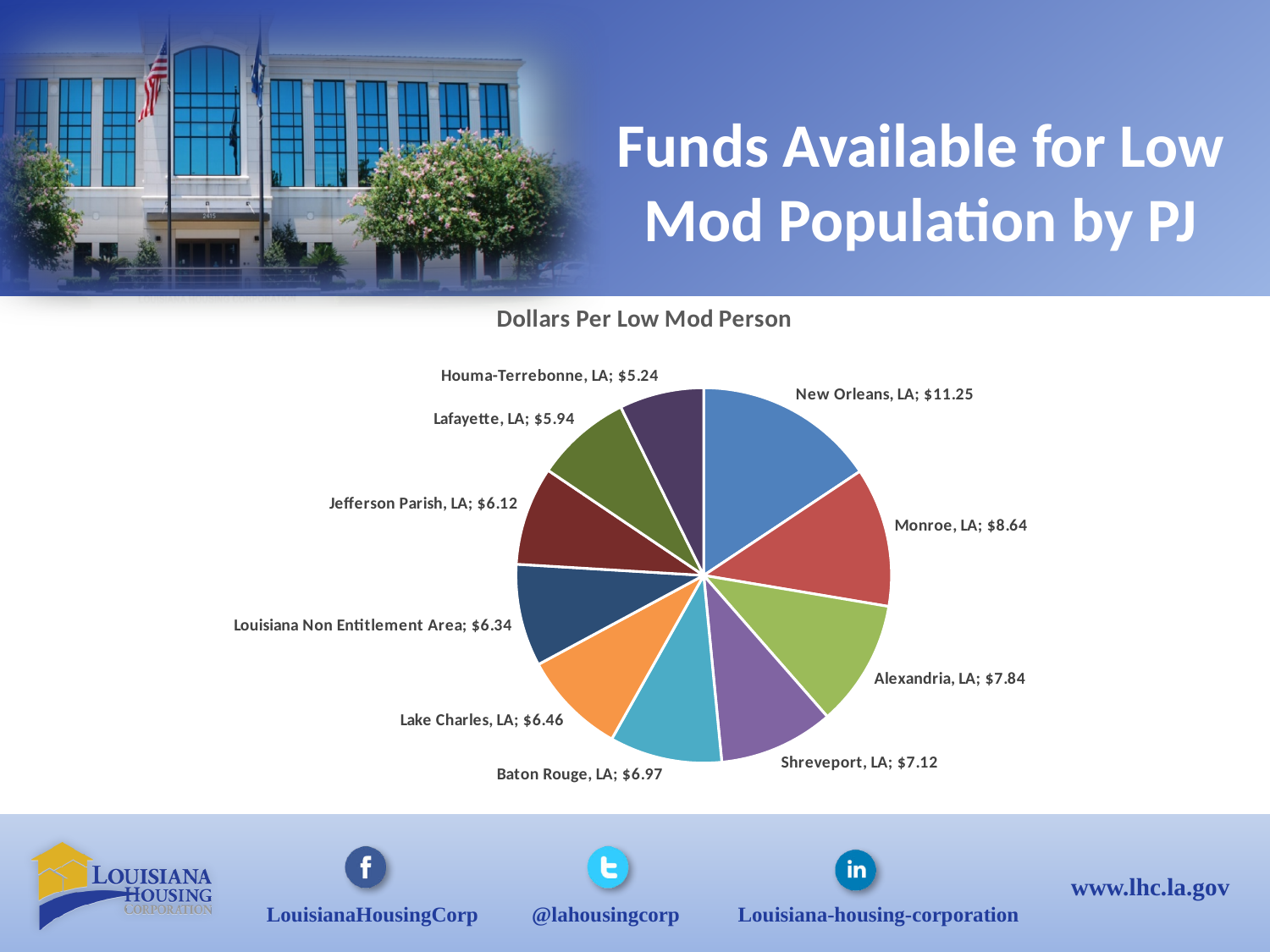
Which category has the lowest dollars per low mod person? Houma-Terrebonne, LA What is the value for New Orleans, LA in the pie chart? $11.25 What kind of chart is shown on the slide? Pie chart What is the difference between the values for New Orleans, LA and Houma-Terrebonne, LA? $6.01 What is the difference between the values for Monroe, LA and Alexandria, LA? $0.80 What is the value for Shreveport, LA? $7.12 Which is larger, the value for Lafayette, LA or Jefferson Parish, LA? Jefferson Parish, LA What is the title of the chart? Dollars Per Low Mod Person Which category has the highest dollars per low mod person? New Orleans, LA How many slices does the pie chart have? 10 What is the value for Louisiana Non Entitlement Area? $6.34 Which is larger, the value for Baton Rouge, LA or Lake Charles, LA? Baton Rouge, LA